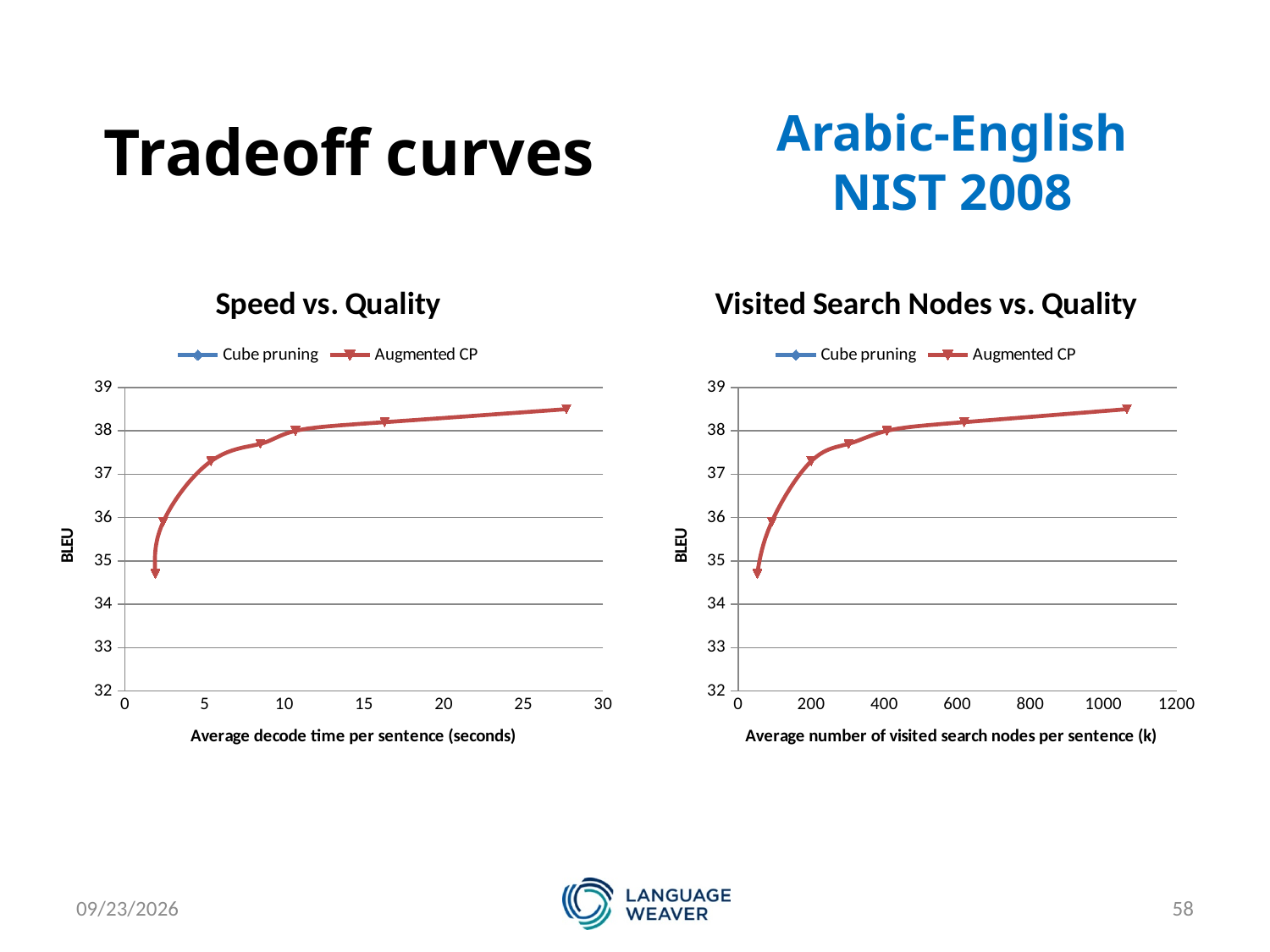
In the "Speed vs. Quality" chart, is the BLEU value of the Augmented CP point with the lowest decode time greater or less than 35? less What kind of chart is the "Speed vs. Quality" chart? line chart What are the two series named in the legend of the "Visited Search Nodes vs. Quality" chart? Cube pruning and Augmented CP What is the x-axis label of the "Visited Search Nodes vs. Quality" chart? Average number of visited search nodes per sentence (k) How many Augmented CP data points are plotted in the "Speed vs. Quality" chart? 7 In the "Visited Search Nodes vs. Quality" chart, is the BLEU value of the Augmented CP point with the most visited search nodes greater or less than 38? greater In the "Visited Search Nodes vs. Quality" chart, is the BLEU value of the Augmented CP point with the fewest visited search nodes greater or less than 35? less In the "Visited Search Nodes vs. Quality" chart, does BLEU rise or fall as the average number of visited search nodes increases? rise How many series does the legend of the "Speed vs. Quality" chart list? 2 In the "Speed vs. Quality" chart, does BLEU rise or fall as average decode time per sentence increases? rise What is the y-axis label of the "Speed vs. Quality" chart? BLEU